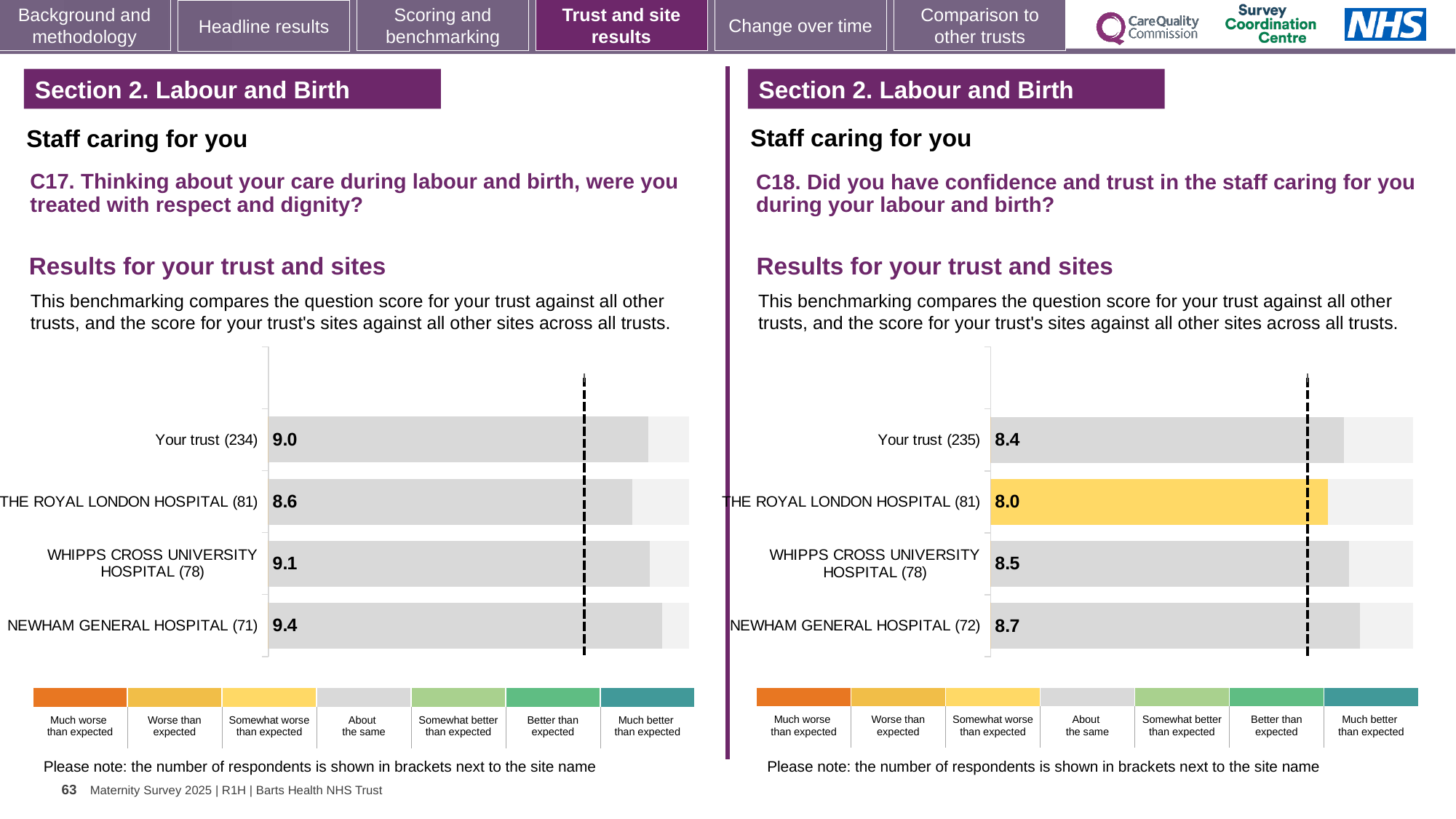
What kind of chart is used in the C17 chart on the left? Bar chart In the C18 chart on the right, which site or trust has the highest score? NEWHAM GENERAL HOSPITAL In the C18 chart on the right, what is the difference between the scores for NEWHAM GENERAL HOSPITAL and Your trust? 0.3 In the C18 chart on the right, what is the score for THE ROYAL LONDON HOSPITAL? 8.0 In the C17 chart on the left, what is the difference between the scores for NEWHAM GENERAL HOSPITAL and THE ROYAL LONDON HOSPITAL? 0.8 In the C17 chart on the left, how many bars are plotted? 4 In the C18 chart on the right, what is the score for WHIPPS CROSS UNIVERSITY HOSPITAL? 8.5 In the C17 chart on the left, what is the score for Your trust? 9.0 In the C18 chart on the right, which is larger: the score for Your trust or the score for THE ROYAL LONDON HOSPITAL? Your trust In the C17 chart on the left, what is the score for NEWHAM GENERAL HOSPITAL? 9.4 In the C17 chart on the left, which site or trust has the lowest score? THE ROYAL LONDON HOSPITAL In the C18 chart on the right, which benchmark category does the yellow colour of THE ROYAL LONDON HOSPITAL bar indicate according to the legend? Somewhat worse than expected